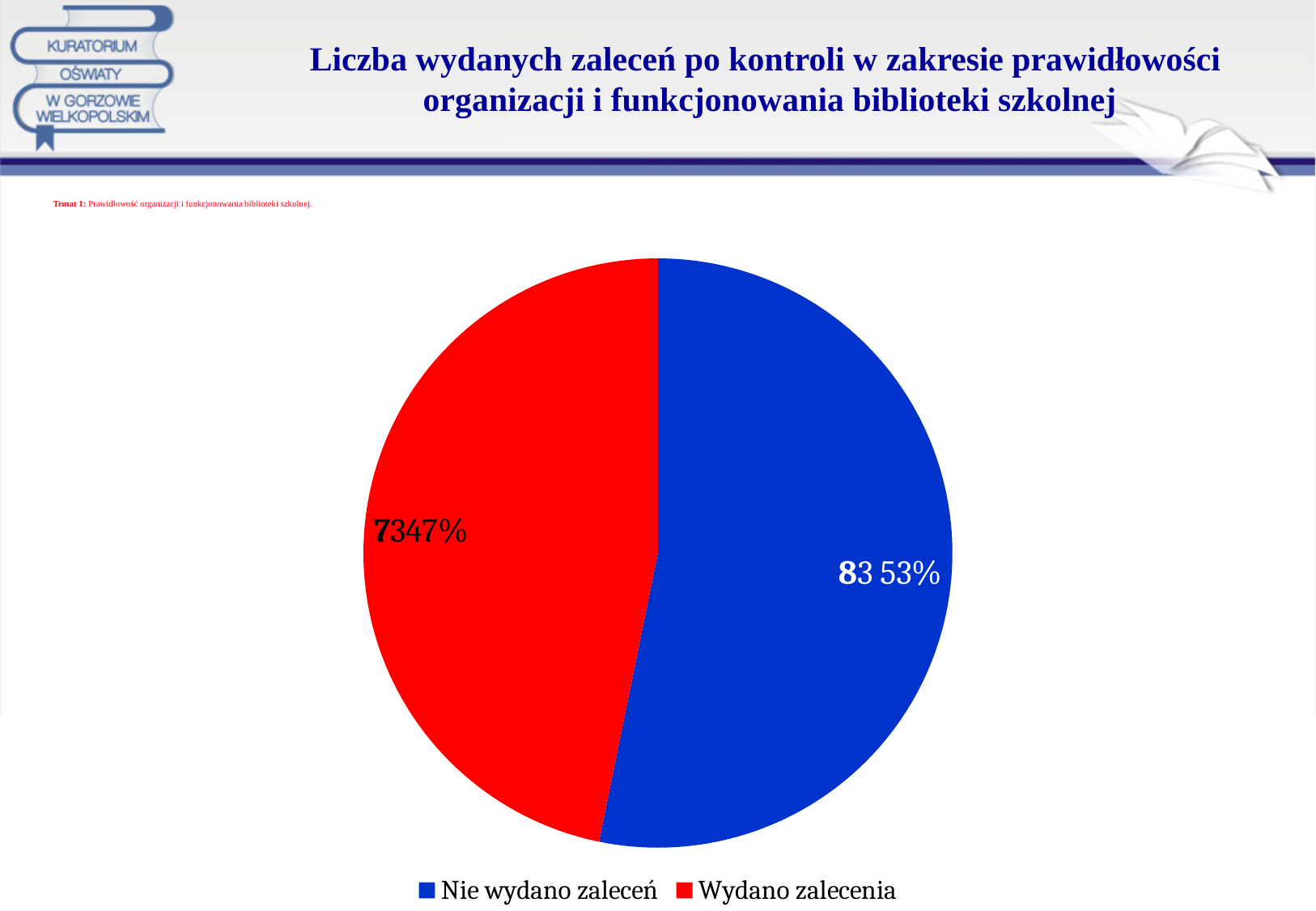
How many slices does the pie chart have? 2 What is the number shown for 'Nie wydano zaleceń'? 83 What is the difference between the number for 'Nie wydano zaleceń' and the number for 'Wydano zalecenia'? 10 What kind of chart is shown on the slide? pie chart How many entries does the legend list? 2 What percentage share does the 'Wydano zalecenia' slice have? 47% What colour is the 'Wydano zalecenia' slice? red Which category has the largest slice of the pie? Nie wydano zaleceń Which category has the smallest slice of the pie? Wydano zalecenia What percentage share does the 'Nie wydano zaleceń' slice have? 53% What is the number shown for 'Wydano zalecenia'? 73 Which is larger, the value for 'Nie wydano zaleceń' or for 'Wydano zalecenia'? Nie wydano zaleceń